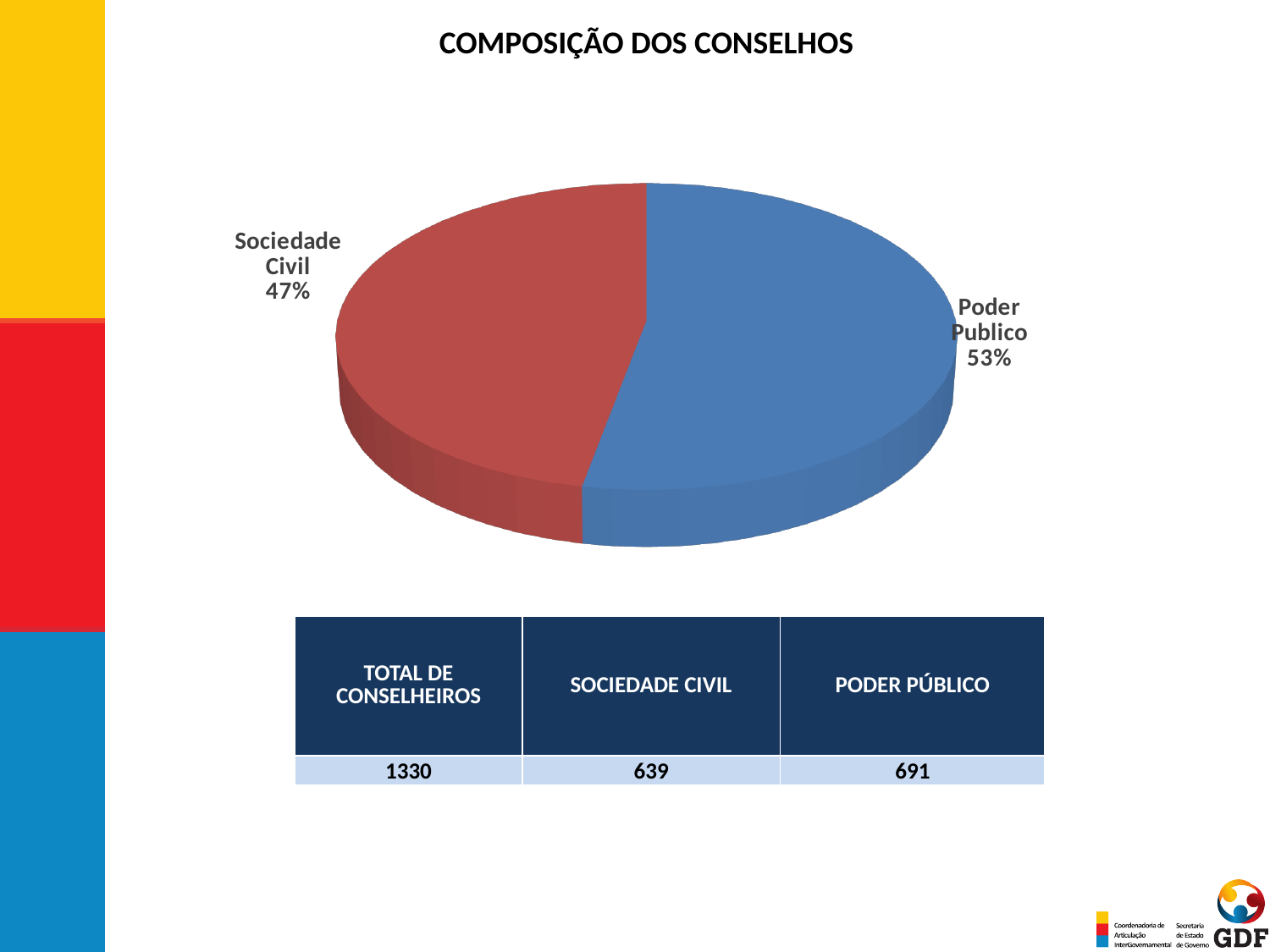
What percentage of the pie is Poder Publico? 53% What colour is the Sociedade Civil slice? red What is the title of the chart? COMPOSIÇÃO DOS CONSELHOS What is the difference in percentage points between the Poder Publico and Sociedade Civil slices? 6 percentage points How many slices does the pie chart have? 2 Which is larger, the Sociedade Civil slice or the Poder Publico slice? Poder Publico Which slice of the pie is the smallest? Sociedade Civil What kind of chart is shown on the slide? pie chart Which slice of the pie is the largest? Poder Publico According to the table below the chart, how many conselheiros are from Sociedade Civil? 639 According to the table below the chart, what is the total number of conselheiros? 1330 What percentage of the pie is Sociedade Civil? 47%